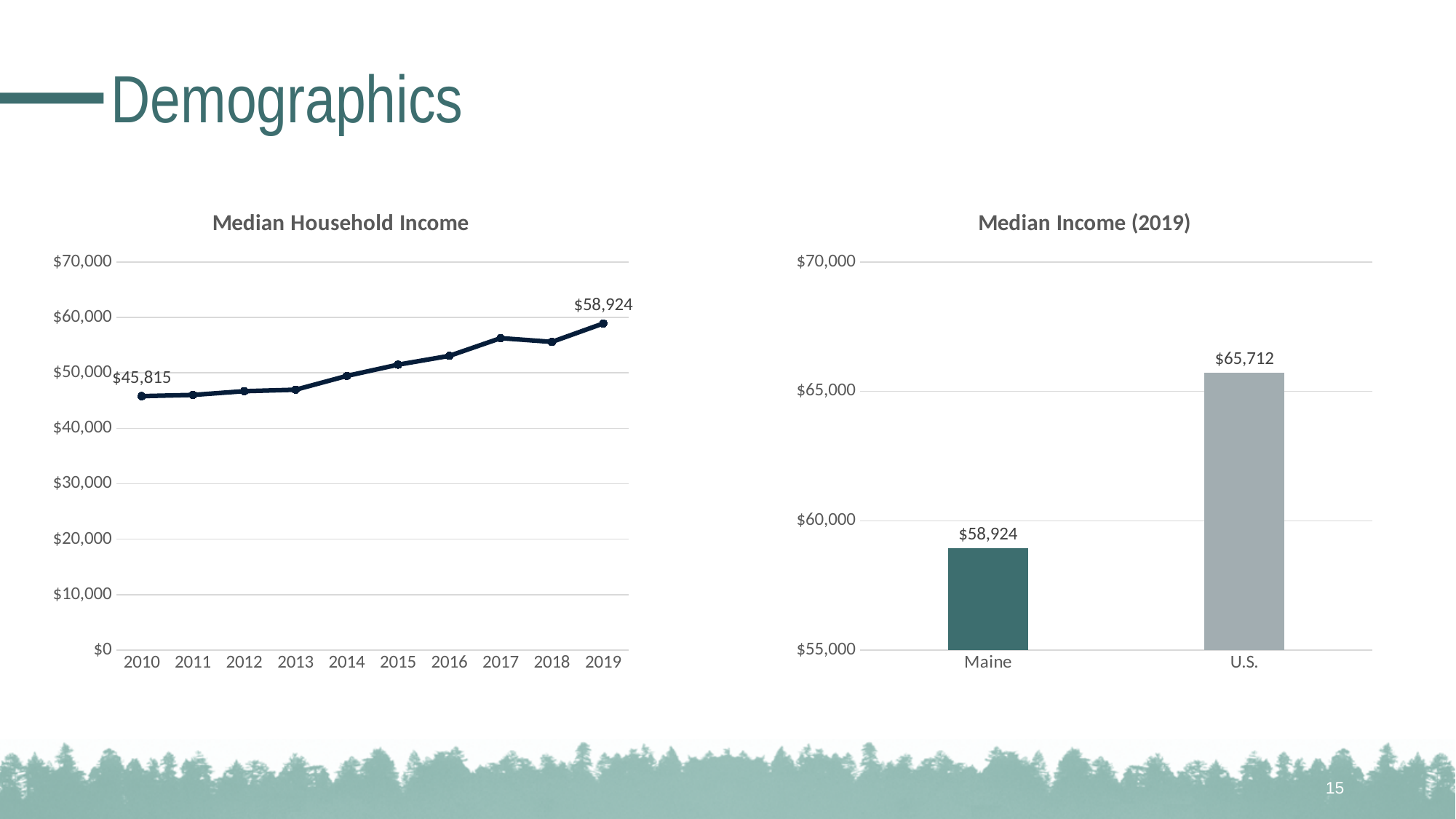
In the 'Median Income (2019)' chart, what is the value for the U.S.? $65,712 What kind of chart is the 'Median Income (2019)' chart? bar chart In the 'Median Household Income' chart, what is the value for 2010? $45,815 In the 'Median Household Income' chart, is the value for 2013 greater or less than $50,000? less In the 'Median Household Income' chart, what is the value for 2019? $58,924 In the 'Median Income (2019)' chart, what is the value for Maine? $58,924 In the 'Median Income (2019)' chart, what is the difference between the U.S. and Maine values? $6,788 In the 'Median Household Income' chart, what is the difference between the 2019 and 2010 values? $13,109 What kind of chart is the 'Median Household Income' chart? line chart In the 'Median Household Income' chart, do the values generally rise or fall from 2010 to 2019? rise In the 'Median Household Income' chart, how many years are plotted on the x axis? 10 In the 'Median Household Income' chart, is the value for 2017 greater or less than $50,000? greater